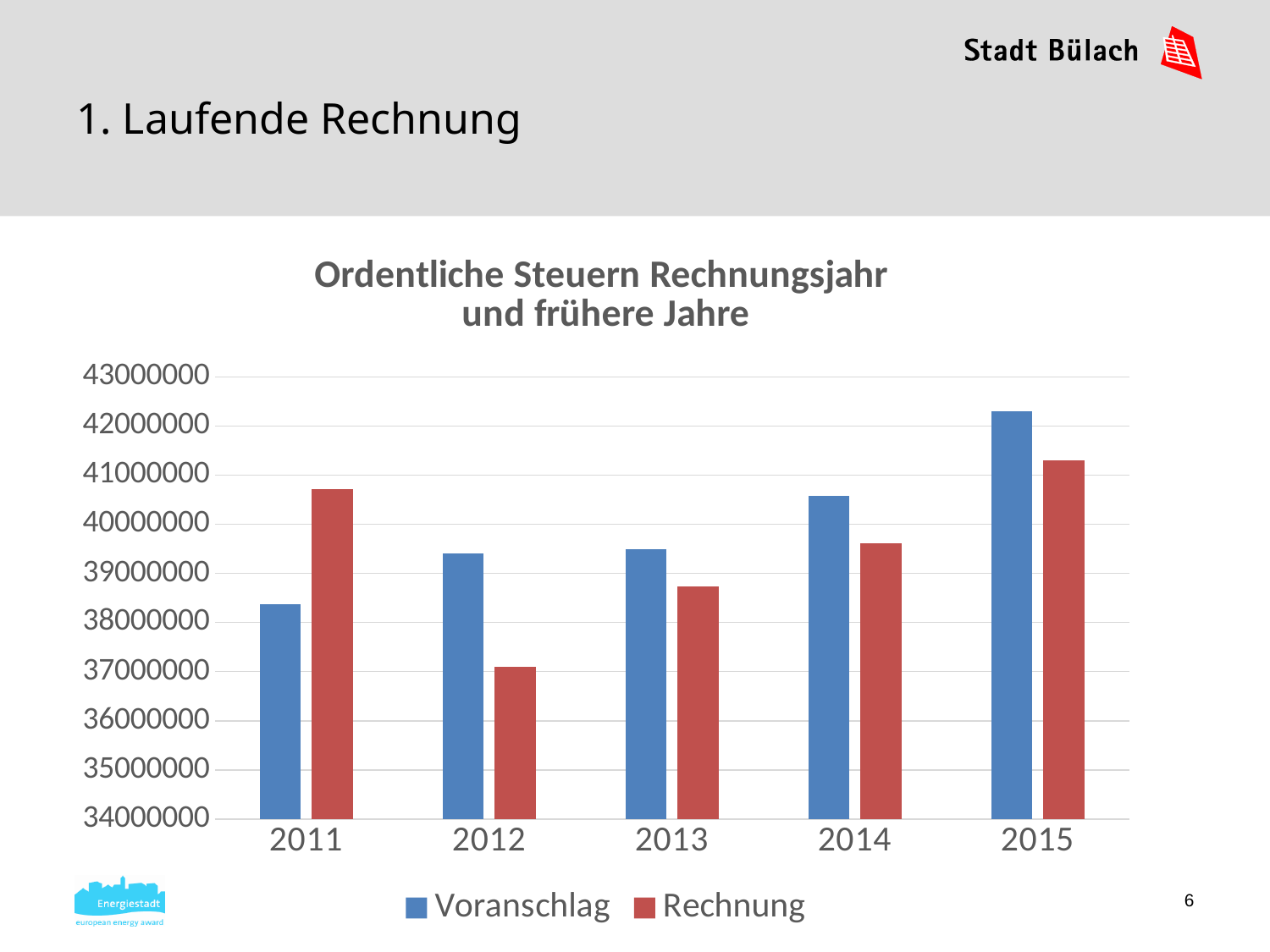
In 2011, which is larger, Voranschlag or Rechnung? Rechnung Which year has the lowest Voranschlag value? 2011 What kind of chart is shown on the slide? bar chart Which year has the highest Rechnung value? 2015 What is the title of the chart? Ordentliche Steuern Rechnungsjahr und frühere Jahre Does the Voranschlag series rise or fall from 2011 to 2015? rise Which year has the lowest Rechnung value? 2012 How many years are shown on the x axis? 5 Is the Voranschlag value for 2015 greater or less than 42000000? greater How many series does the legend list? 2 In 2012, which is larger, Voranschlag or Rechnung? Voranschlag Which year has the highest Voranschlag value? 2015